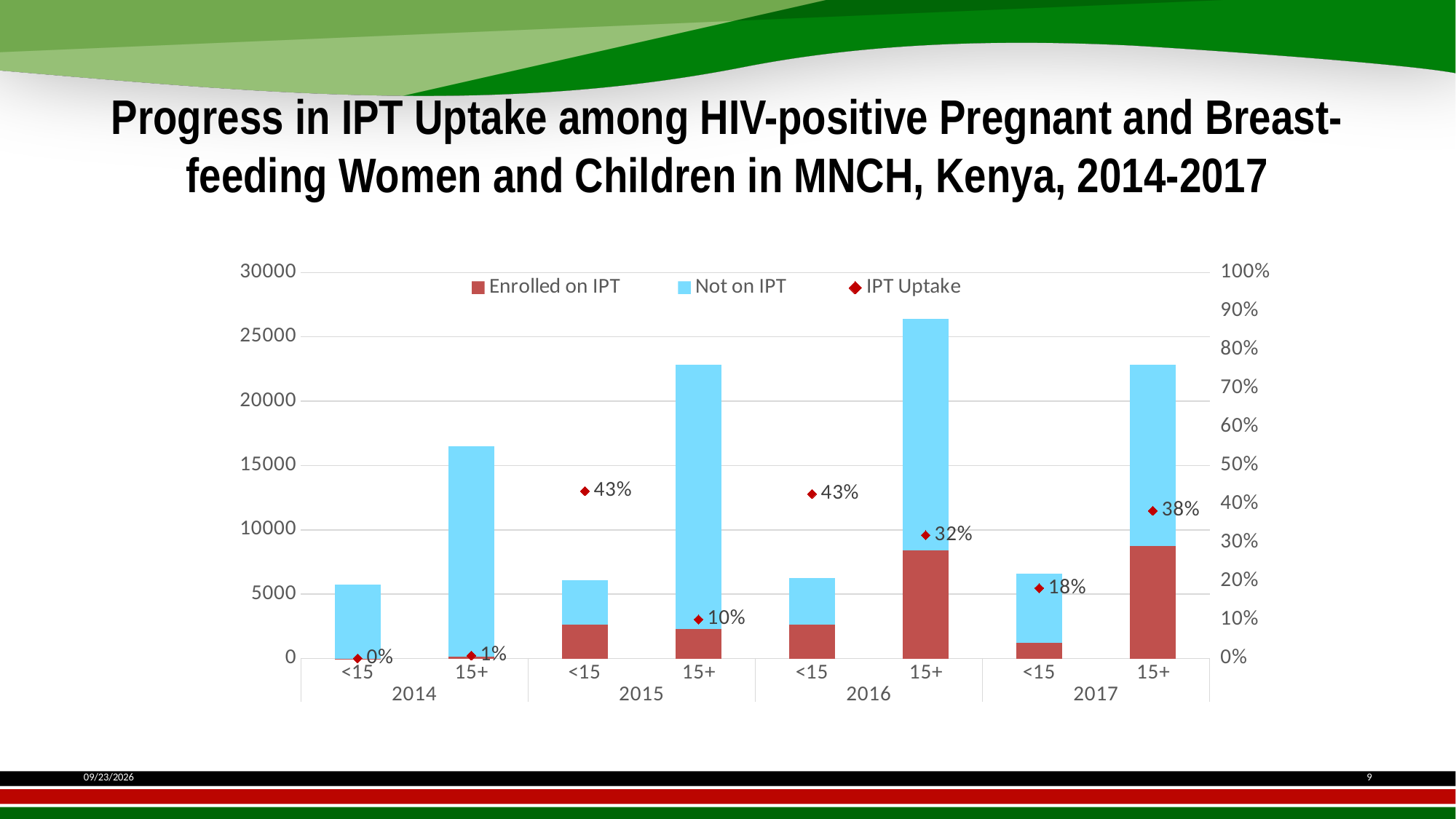
Which group and year has the lowest IPT Uptake value? <15 in 2014 (0%) Is the total stacked bar height for the 15+ group in 2014 greater or less than 15000? greater Does the IPT Uptake for the 15+ group rise or fall from 2014 to 2017? rise What is the difference in IPT Uptake between the 15+ group in 2017 and the 15+ group in 2016? 6% What is the IPT Uptake value for the 15+ group in 2017? 38% How many series does the legend list? 3 How many stacked bars are plotted in the chart? 8 Which has a higher IPT Uptake: the 15+ group in 2015 or the 15+ group in 2016? 15+ in 2016 What is the IPT Uptake value for the 15+ group in 2014? 1% What is the IPT Uptake value for the <15 group in 2015? 43% Is the total stacked bar height for the 15+ group in 2016 greater or less than 25000? greater What is the IPT Uptake value for the <15 group in 2017? 18%